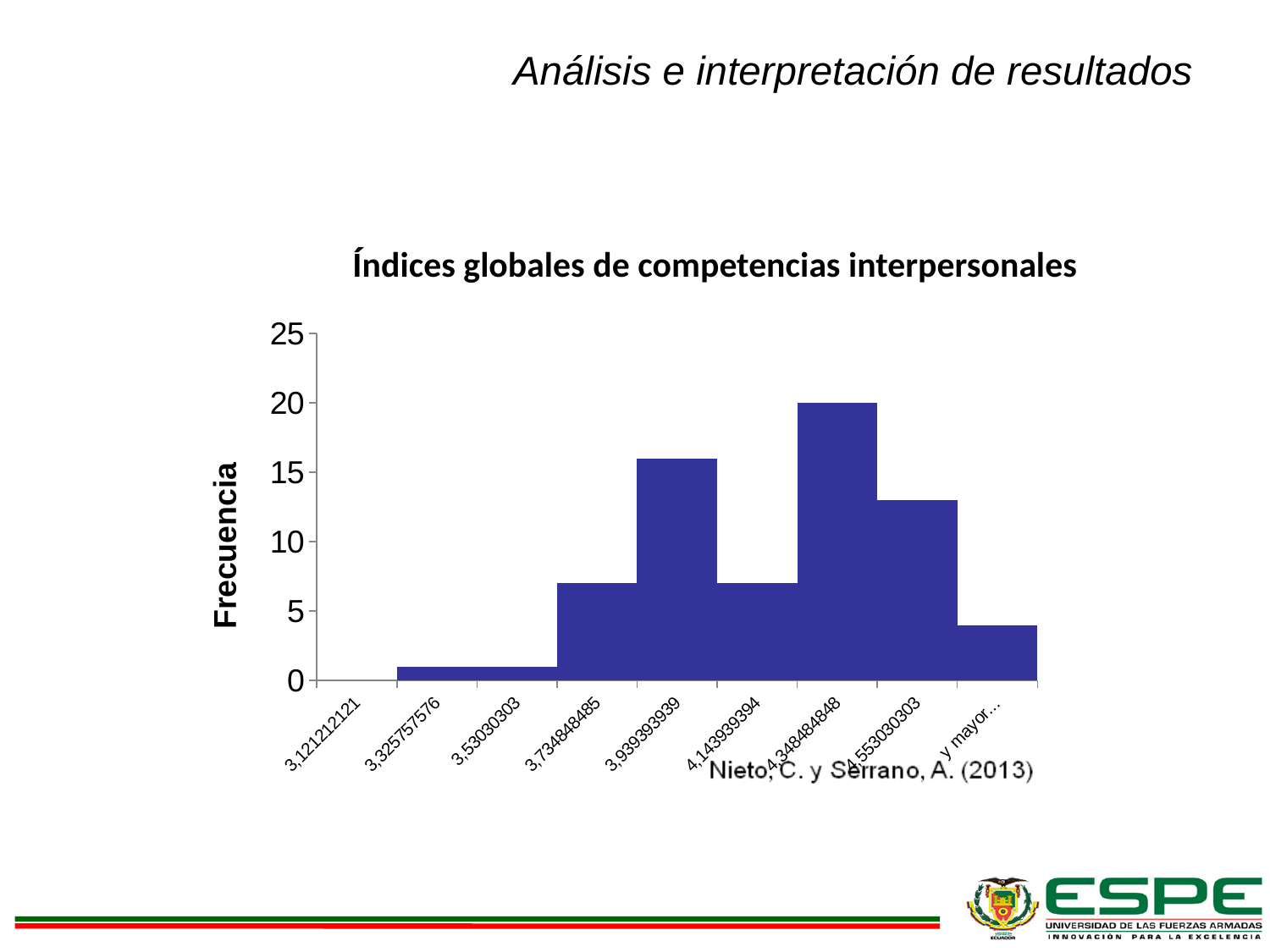
Which has the higher frequency, 3,939393939 or 4,553030303? 3,939393939 Is the frequency for 3,939393939 greater or less than 15? greater How many categories are shown on the x axis? 9 Is the frequency for 4,553030303 greater or less than 10? greater What is the title of the chart? Índices globales de competencias interpersonales What is the label of the vertical axis? Frecuencia What is the frequency for the category 4,348484848? 20 What kind of chart is shown on the slide? bar chart Which category has the highest frequency? 4,348484848 Which category has a frequency of 0 (no bar)? 3,121212121 Is the frequency for the category 'y mayor...' greater or less than 5? less